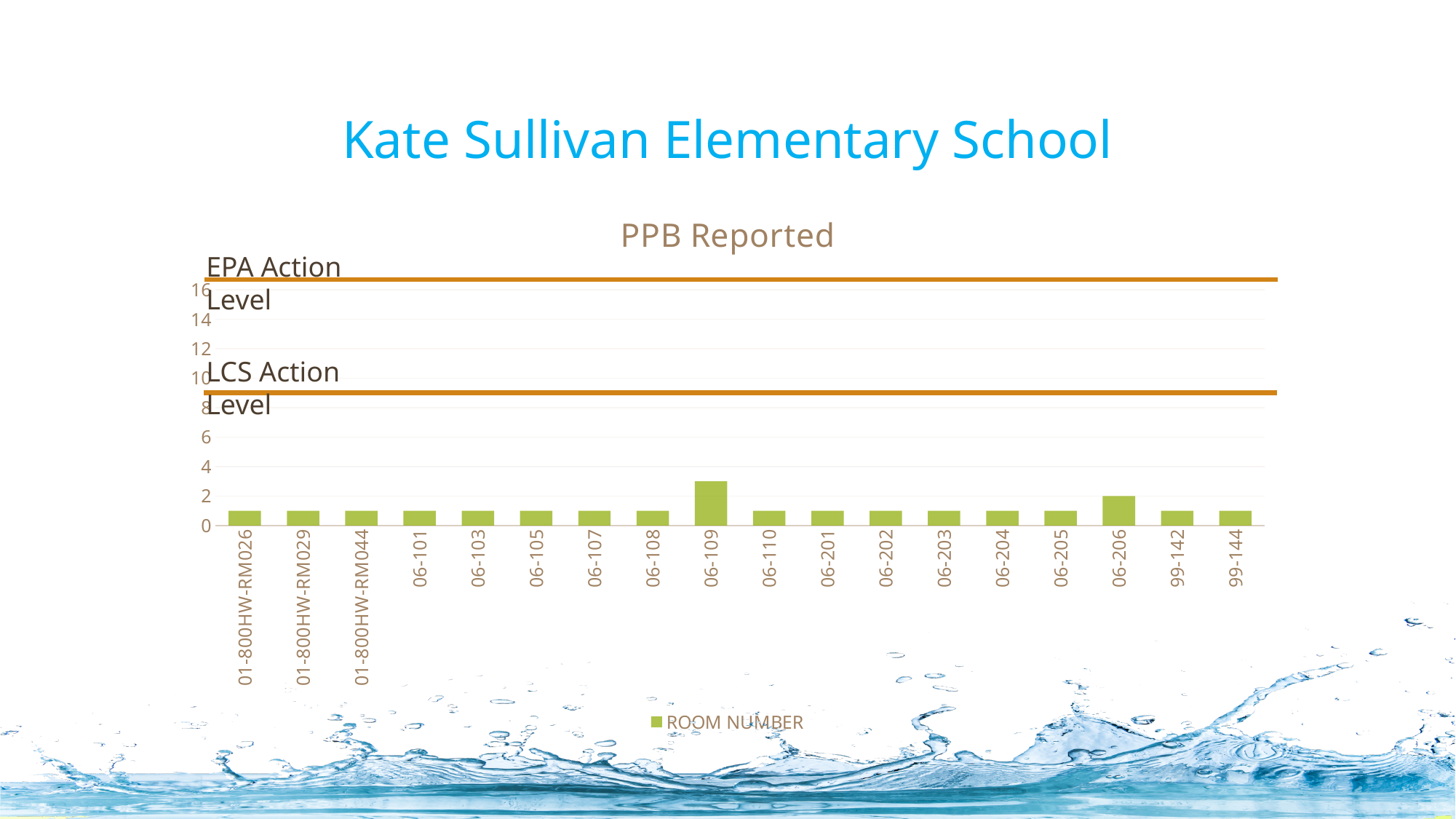
Which room number has the highest PPB reported value? 06-109 Which has a larger PPB reported value, 06-109 or 06-206? 06-109 How many series does the legend list? 1 Which has a larger PPB reported value, 06-206 or 99-144? 06-206 What is the title of the chart? PPB Reported What type of chart is shown on the slide? bar chart Is the value for 06-109 greater or less than 4? less Is the value for 06-109 greater or less than 2? greater Is the value for 06-101 greater or less than 2? less What is the name of the series shown in the legend? ROOM NUMBER How many categories (room numbers) are plotted on the x axis? 18 What is the PPB reported value for room 06-206? 2